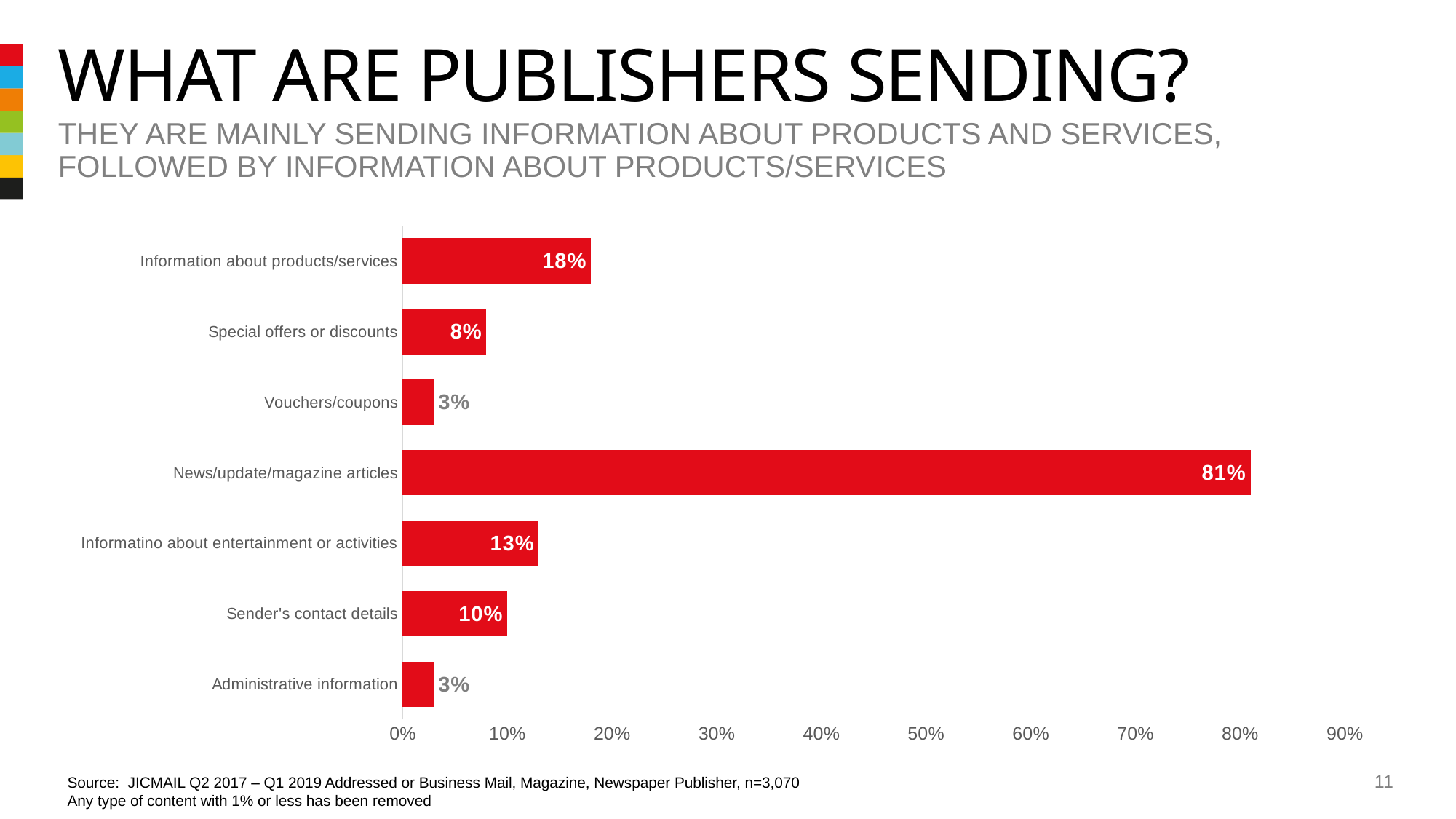
What is the value for News/update/magazine articles? 81% Which is larger, the value for Special offers or discounts or the value for Sender's contact details? Sender's contact details What is the value for Information about products/services? 18% What is the value for Sender's contact details? 10% What is the value for Special offers or discounts? 8% How many categories are shown in the chart? 7 What is the difference between the values for Information about entertainment or activities and Sender's contact details? 3% What kind of chart is shown on the slide? bar chart Which category has the highest value? News/update/magazine articles What is the highest value shown on the x axis? 90% What is the difference between the values for News/update/magazine articles and Information about products/services? 63% Is the value for News/update/magazine articles greater or less than 70%? greater